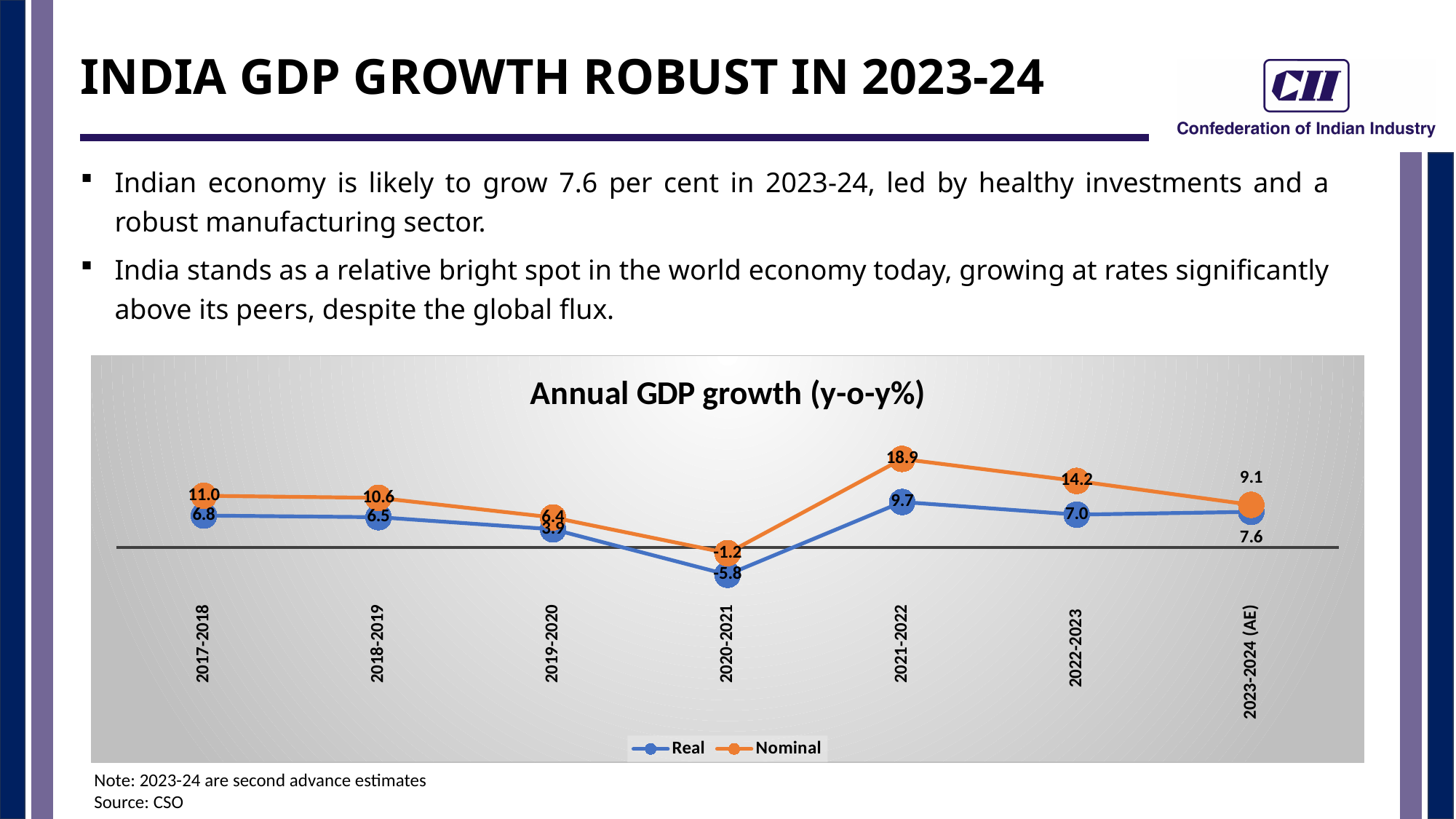
Which year has the lowest Real GDP growth? 2020-2021 Does the Nominal GDP growth rise or fall from 2021-2022 to 2023-2024 (AE)? Fall Which is larger, the Real GDP growth in 2021-2022 or in 2022-2023? 2021-2022 What is the Real GDP growth value for 2020-2021? -5.8 What type of chart is shown on the slide? Line chart Which year has the highest Nominal GDP growth? 2021-2022 What is the Real GDP growth value for 2023-2024 (AE)? 7.6 What is the title of the chart? Annual GDP growth (y-o-y%) How many series does the chart legend list? 2 What is the Nominal GDP growth value for 2021-2022? 18.9 What is the difference between Nominal and Real GDP growth in 2022-2023? 7.2 How many years are shown on the x axis of the chart? 7